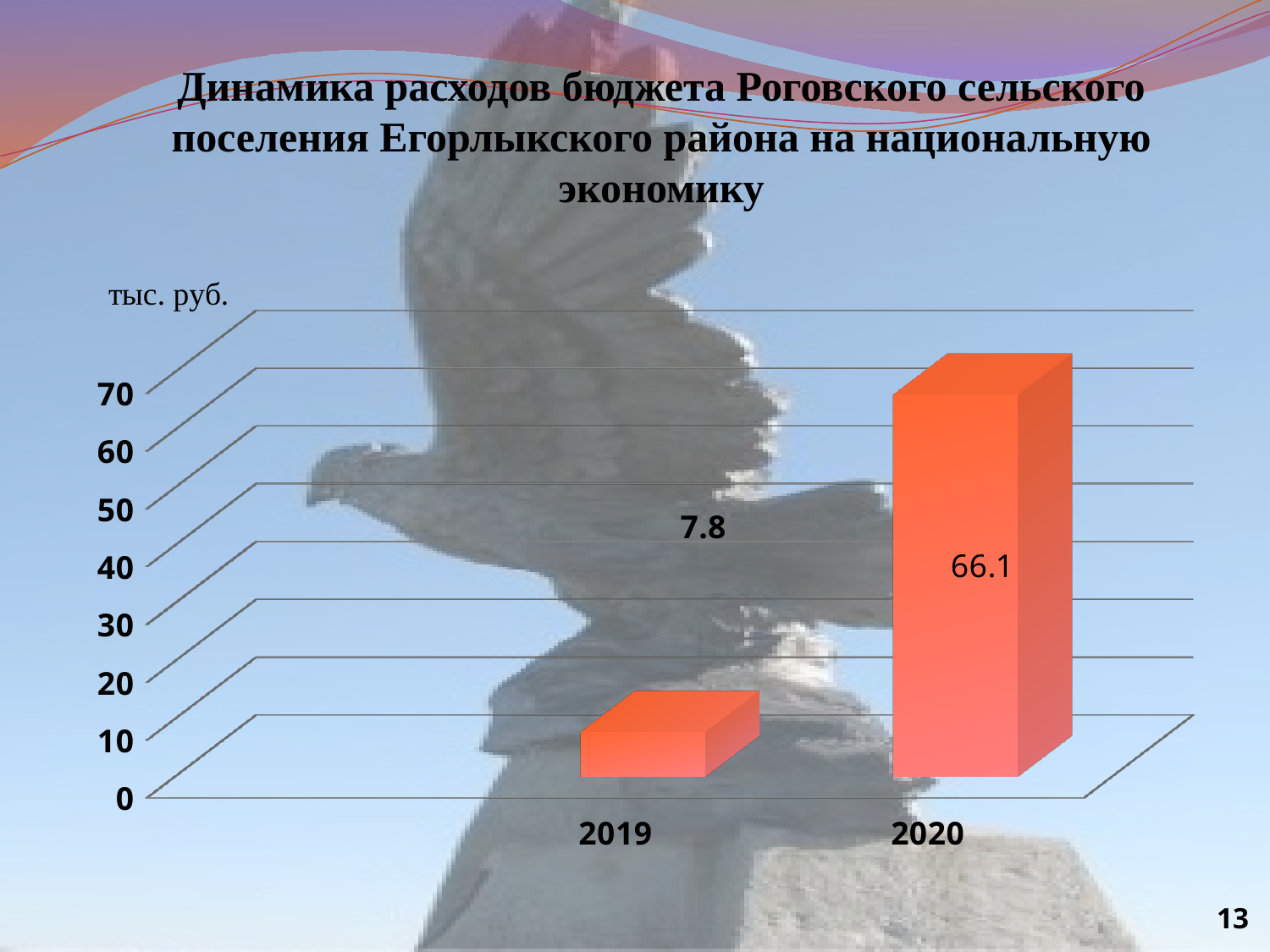
Is the value for 2020 greater or less than 60? greater How many years are shown on the chart? 2 What unit is indicated on the chart's axis label? тыс. руб. What is the difference between the values for 2020 and 2019? 58.3 What kind of chart is shown on the slide? bar chart What is the value for 2020? 66.1 Is the value for 2019 greater or less than 10? less Do the values rise or fall from 2019 to 2020? rise Which is larger, the value for 2019 or the value for 2020? 2020 What is the value for 2019? 7.8 Which year has the lowest value? 2019 Which year has the highest value? 2020